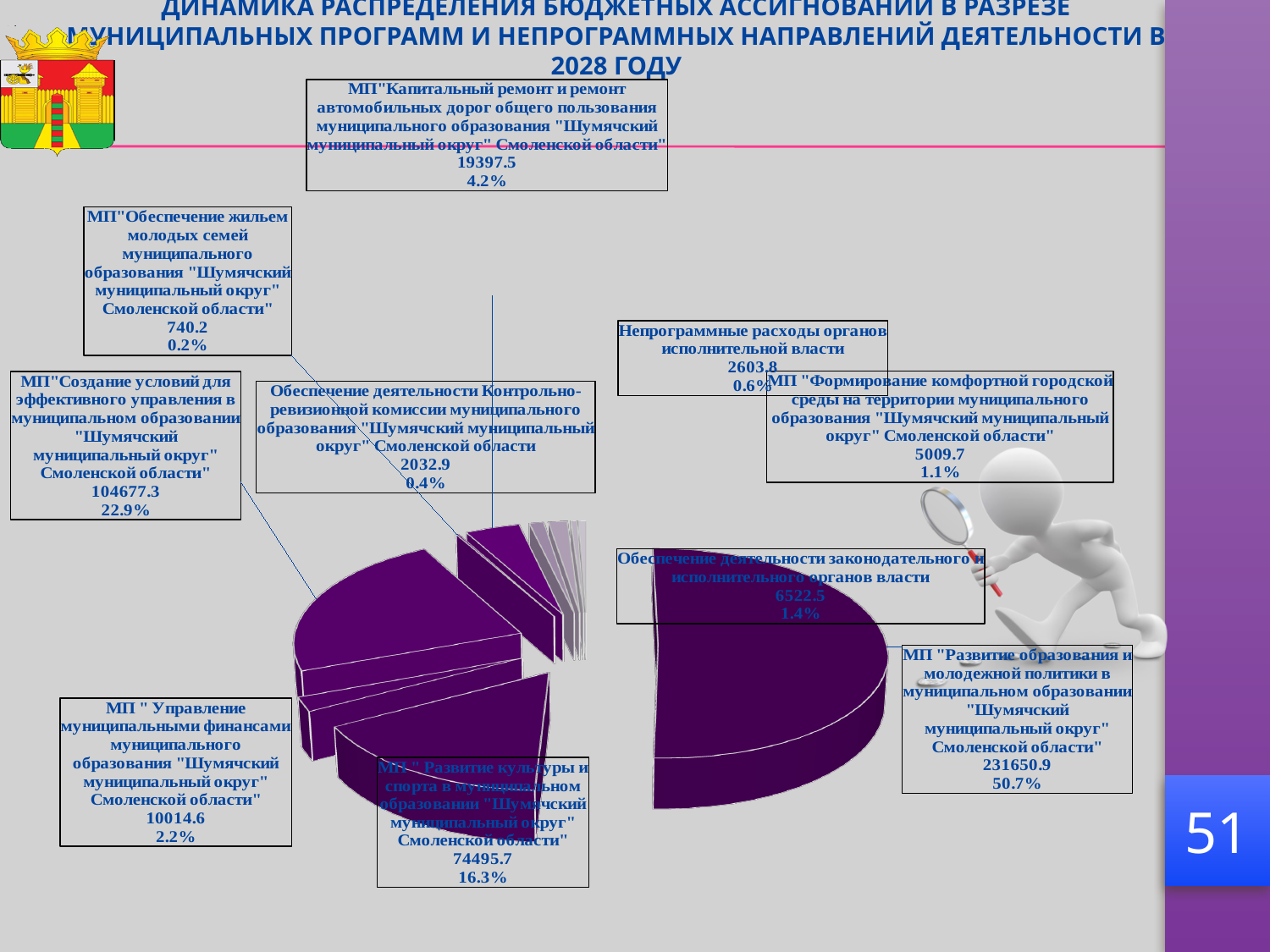
Which is larger: the value for МП "Управление муниципальными финансами" or for МП "Формирование комфортной городской среды"? МП "Управление муниципальными финансами" What value is shown for МП "Развитие культуры и спорта"? 74495.7 What kind of chart is shown on the slide? pie chart What is the difference between the values for МП "Развитие образования и молодежной политики" and МП "Развитие культуры и спорта"? 157155.2 What share of the pie does МП "Создание условий для эффективного управления" have? 22.9% What share of the pie does МП "Развитие образования и молодежной политики" have? 50.7% Which category has the largest share of the pie? МП "Развитие образования и молодежной политики" Which category has the smallest share of the pie? МП "Обеспечение жильем молодых семей" How many categories are shown in the pie chart? 10 What value is shown for МП "Капитальный ремонт и ремонт автомобильных дорог"? 19397.5 What share of the pie does "Непрограммные расходы органов исполнительной власти" have? 0.6% What value is shown for МП "Развитие образования и молодежной политики"? 231650.9